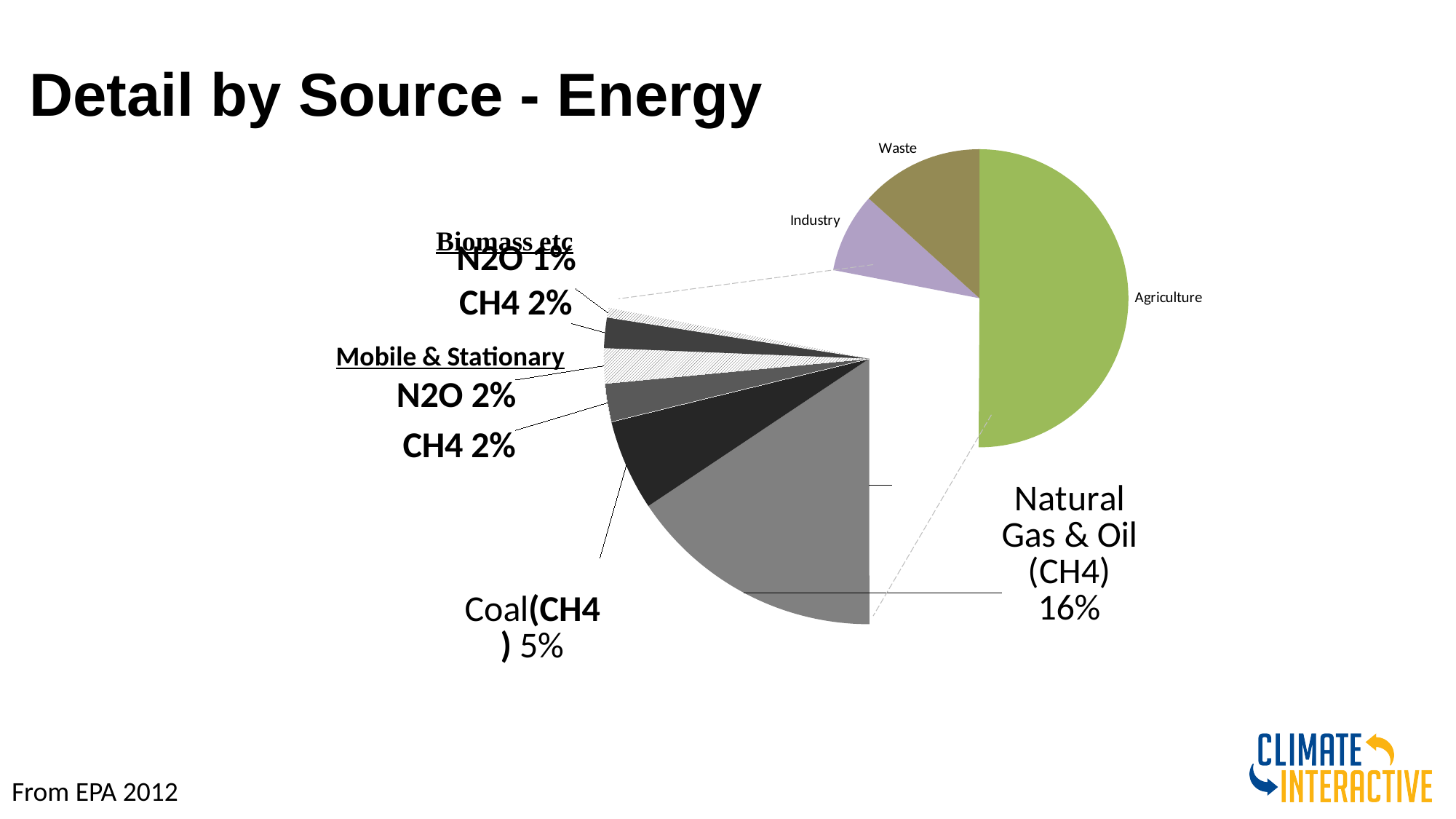
Which slice of the main pie is the largest? Agriculture What is the title of the slide? Detail by Source - Energy Which energy source segment has the highest value? Natural Gas & Oil (CH4) How many segments are shown in the exploded energy detail? 6 What is the value for CH4 under Mobile & Stationary? 2% What is the value for N2O under Biomass etc? 1% What is the value for Natural Gas & Oil (CH4) in the energy detail? 16% What kind of chart is shown on the slide? pie chart What is the difference between Natural Gas & Oil (CH4) and Coal (CH4)? 11 percentage points Which is larger, Coal (CH4) or Mobile & Stationary N2O? Coal (CH4) What is the value for Coal (CH4) in the energy detail? 5% Which energy source segment has the lowest value? Biomass etc N2O